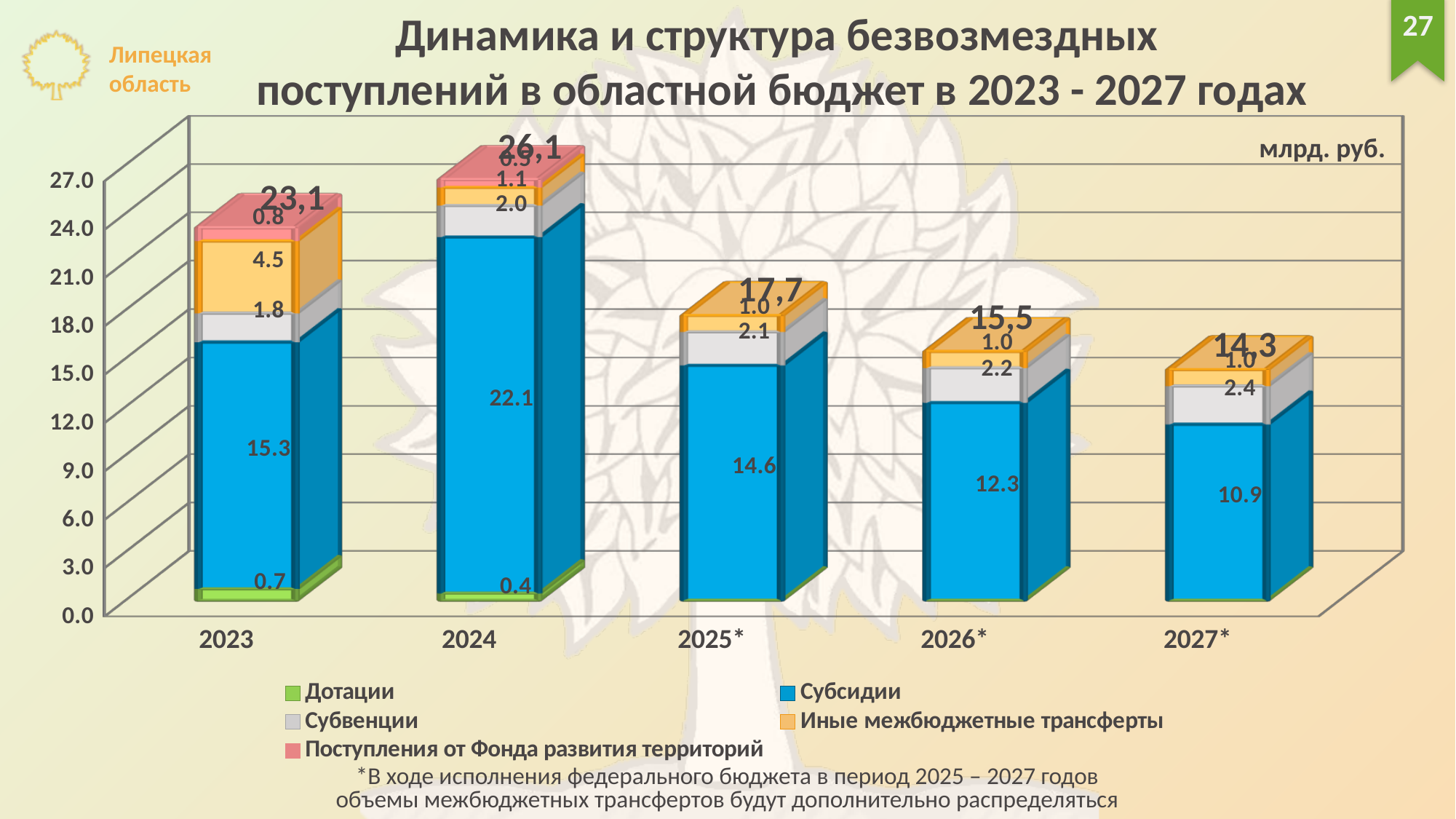
Which year has the highest total of безвозмездные поступления? 2024 What is the value of Иные межбюджетные трансферты for 2023? 4.5 Which year has the lowest total of безвозмездные поступления? 2027* How many series does the legend list? 5 Which is larger: Субсидии in 2025* or Субсидии in 2026*? 2025* What is the total shown above the bar for 2025*? 17,7 Do the totals rise or fall from 2024 to 2027*? Fall What kind of chart is shown on the slide? Stacked bar chart What is the value of Субвенции for 2027*? 2.4 How many years are shown on the x axis? 5 What is the difference between the Субсидии values for 2024 and 2023? 6.8 What is the value of Субсидии for 2024? 22.1